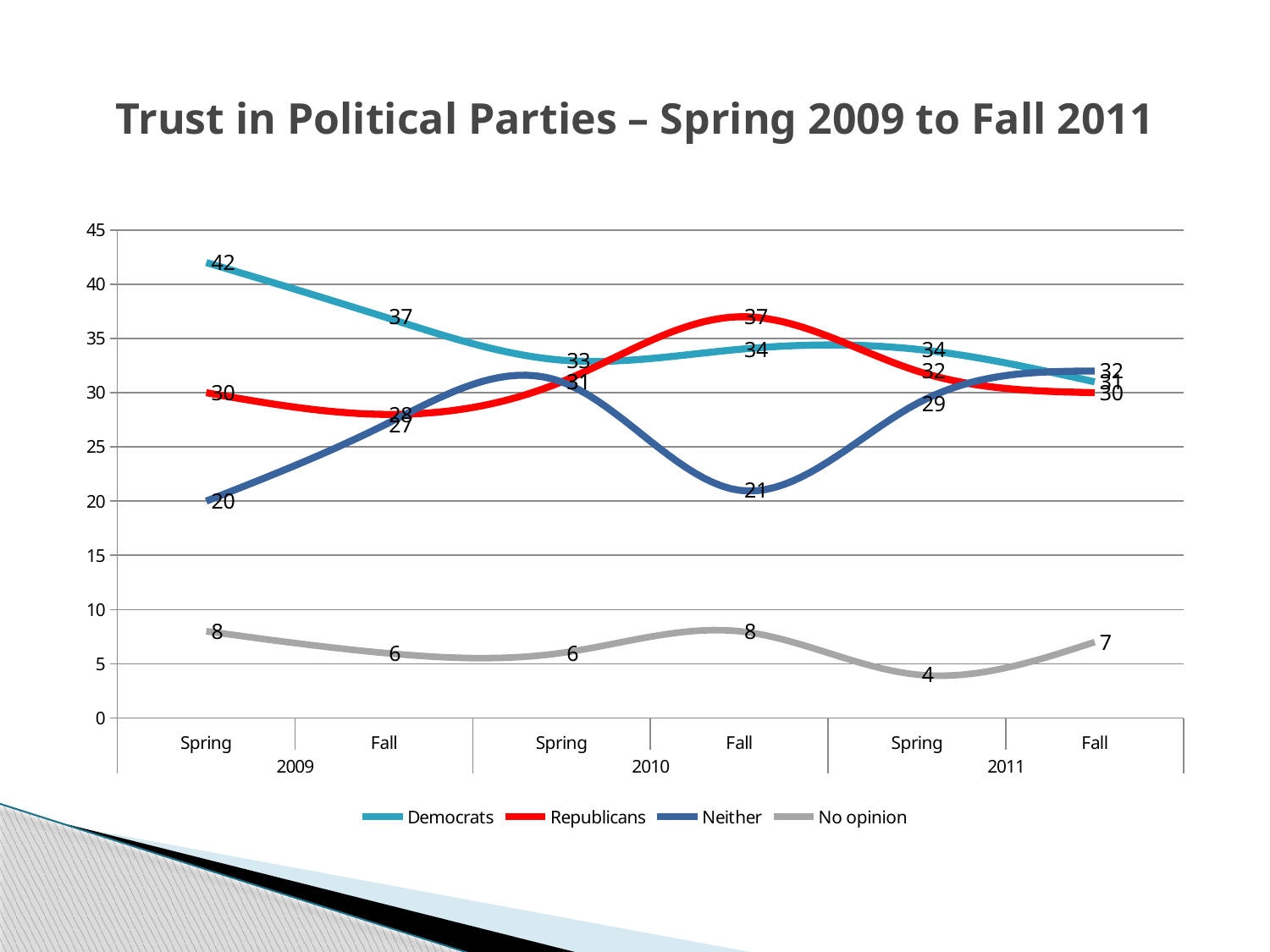
What is the difference between the Democrats values in Spring 2009 and Fall 2009? 5 What is the value for Republicans in Fall 2010? 37 What is the value for Democrats in Spring 2009? 42 Does the Democrats series rise or fall from Spring 2009 to Spring 2010? fall How many survey points are plotted along the x axis? 6 At which point is the Democrats series highest? Spring 2009 What is the value for Neither in Fall 2010? 21 What kind of chart is shown on the slide? line chart At which point is the No opinion series lowest? Spring 2011 In Fall 2010, which is larger: Republicans or Democrats? Republicans How many series does the legend list? 4 What is the value for No opinion in Spring 2011? 4